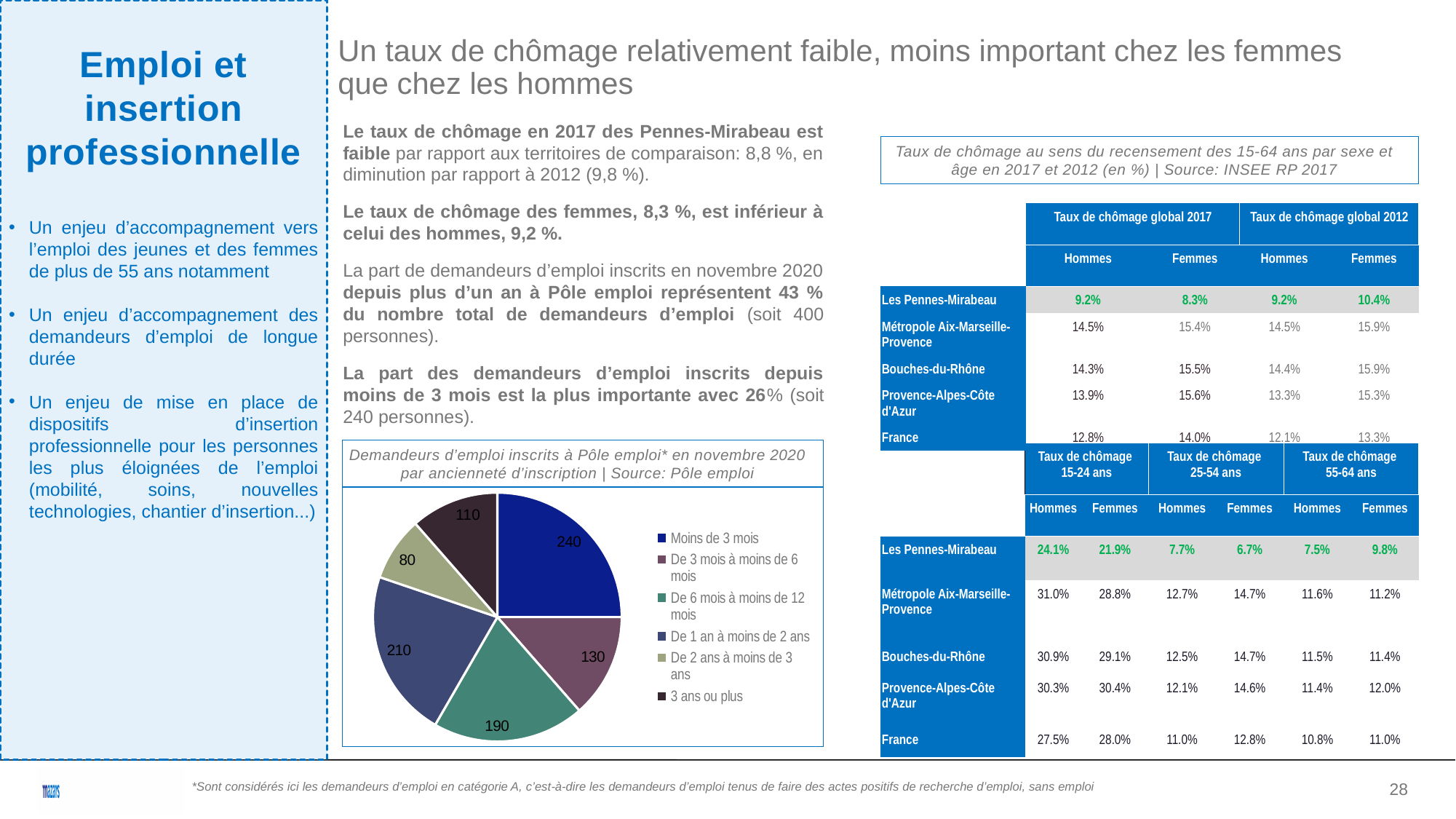
How many slices does the pie chart have? 6 What kind of chart is shown on the slide? Pie chart What is the total of all slices in the pie chart? 960 Which category has the largest slice in the pie chart? Moins de 3 mois Which category has the smallest slice in the pie chart? De 2 ans à moins de 3 ans What is the value for 'Moins de 3 mois' in the pie chart? 240 What is the value for '3 ans ou plus' in the pie chart? 110 What is the difference between the values for 'Moins de 3 mois' and 'De 3 mois à moins de 6 mois' in the pie chart? 110 What is the value for 'De 1 an à moins de 2 ans' in the pie chart? 210 Which is larger in the pie chart: 'De 6 mois à moins de 12 mois' or 'De 1 an à moins de 2 ans'? De 1 an à moins de 2 ans What is the title of the pie chart? Demandeurs d'emploi inscrits à Pôle emploi* en novembre 2020 par ancienneté d'inscription | Source: Pôle emploi What is the value for 'De 2 ans à moins de 3 ans' in the pie chart? 80